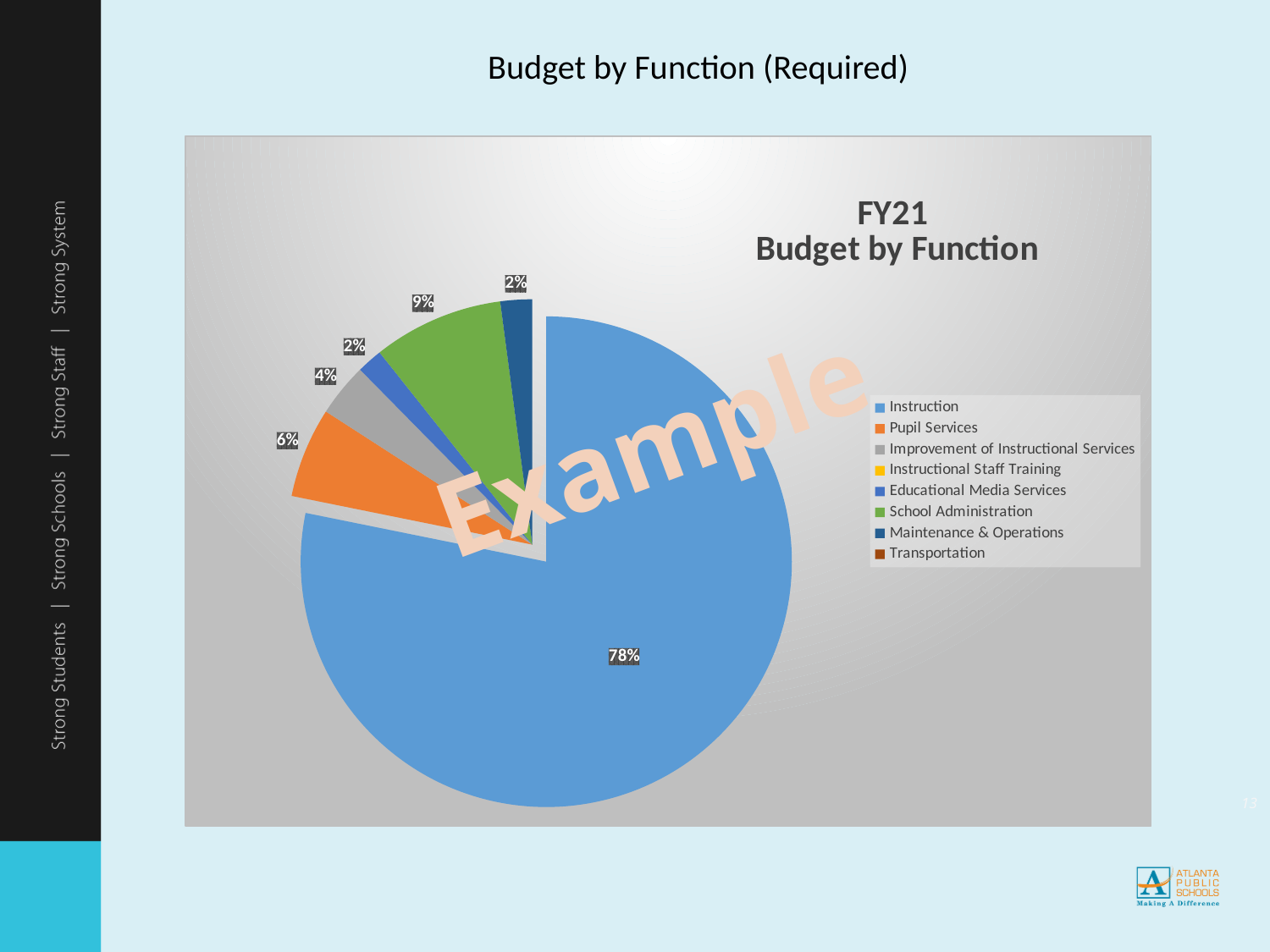
What is the title of the chart? FY21 Budget by Function What share of the FY21 budget goes to School Administration? 9% How many percentage points larger is the Instruction share than the School Administration share? 69 percentage points How many percentage points larger is the Pupil Services share than the Improvement of Instructional Services share? 2 percentage points What share of the FY21 budget goes to Maintenance & Operations? 2% What share of the FY21 budget goes to Pupil Services? 6% How many functions are listed in the chart's legend? 8 Which has a larger share of the budget, School Administration or Pupil Services? School Administration Which function has the largest share of the FY21 budget? Instruction What kind of chart is shown on the slide? pie chart What share of the FY21 budget goes to Improvement of Instructional Services? 4% What share of the FY21 budget goes to Instruction? 78%